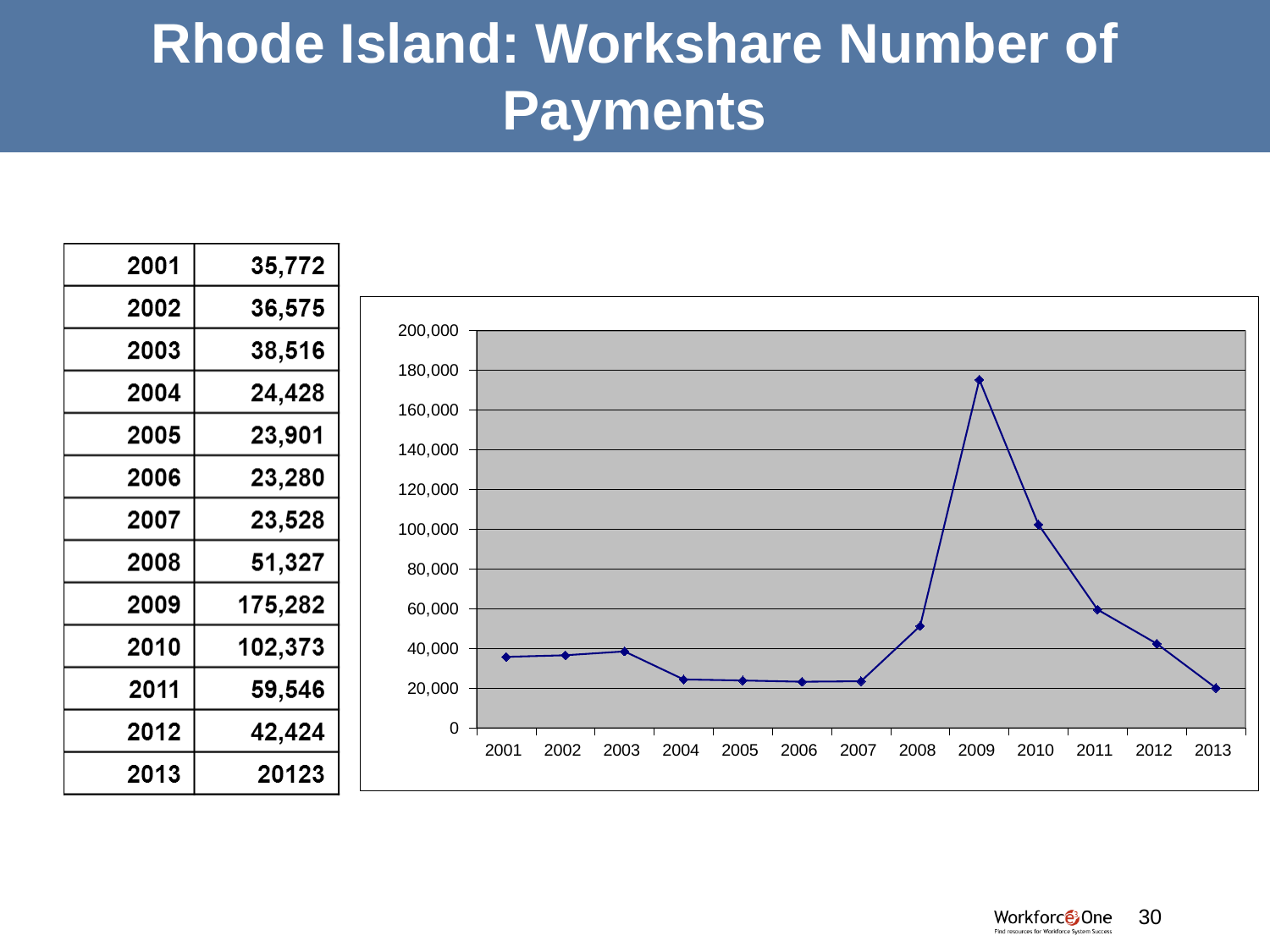
Do the plotted values rise or fall from 2009 to 2013? fall According to the table on the slide, what is the number of payments for 2010? 102,373 Is the value plotted for 2009 greater or less than 160,000? greater How many years are plotted on the x axis of the chart? 13 Using the table values, what is the difference between the 2009 and 2010 payments? 72,909 Which is larger, the value for 2008 or the value for 2011? 2011 Which year has the lowest number of workshare payments? 2013 Which year has the highest number of workshare payments? 2009 Is the value plotted for 2013 greater or less than 40,000? less What kind of chart is shown on the slide? line chart According to the table on the slide, what is the number of payments for 2001? 35,772 According to the table on the slide, what is the number of payments for 2009? 175,282